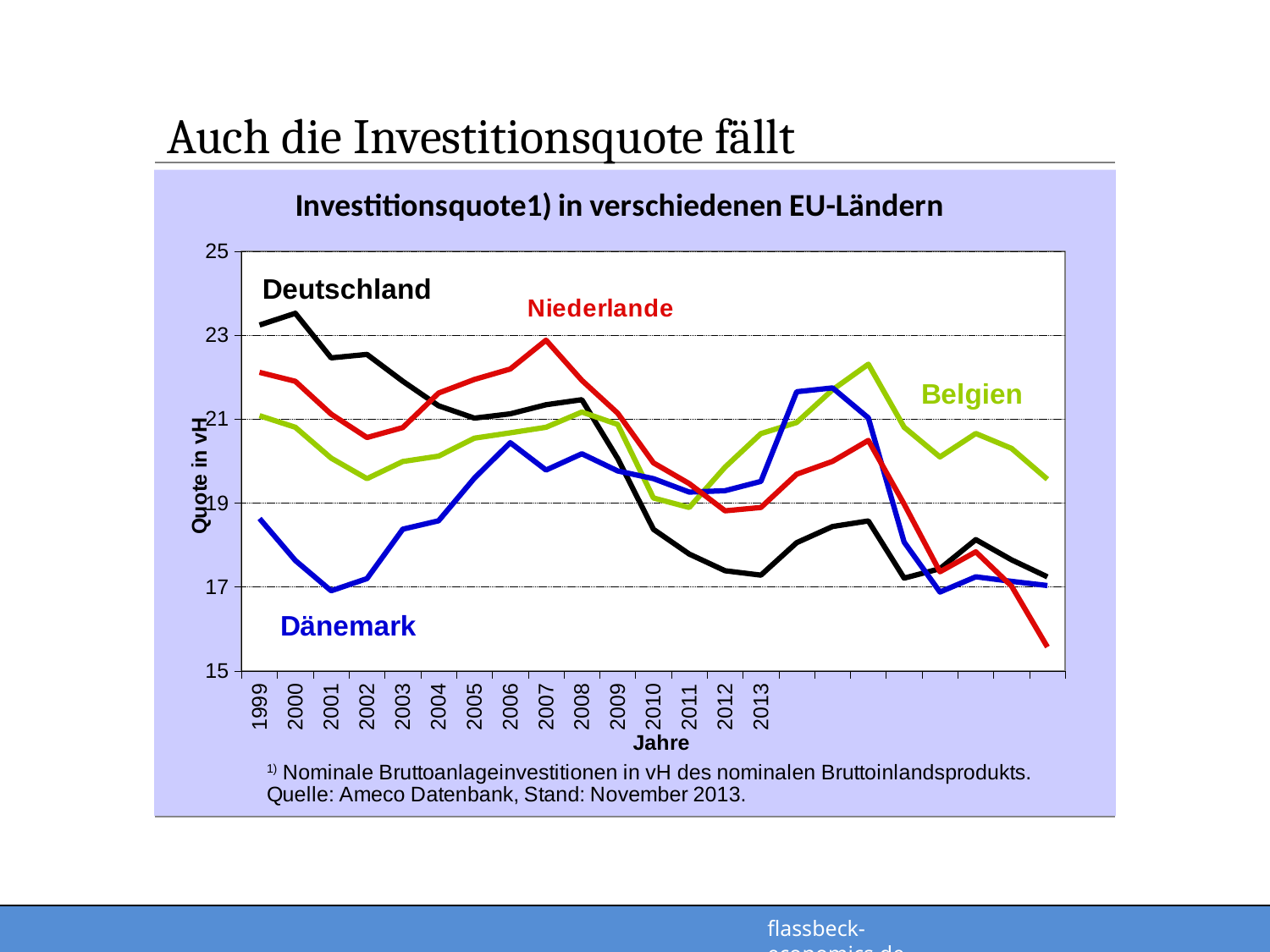
What kind of chart is shown on the slide? line chart Is the value for Deutschland in 2000 greater or less than 23? greater How many countries (series) are plotted in the chart? 4 Which country has the highest investment rate in 1999? Deutschland Which country is plotted with the green line? Belgien Is the value for Dänemark in 1999 greater or less than 19? less Which country has the lowest investment rate in 1999? Dänemark Is the value for Niederlande in 2002 greater or less than 21? less Which country has the highest investment rate in 2013? Belgien What is the title of the chart? Investitionsquote1) in verschiedenen EU-Ländern In 2003, which is larger: the value for Niederlande or the value for Dänemark? Niederlande Which country has the lowest investment rate in 2013? Deutschland